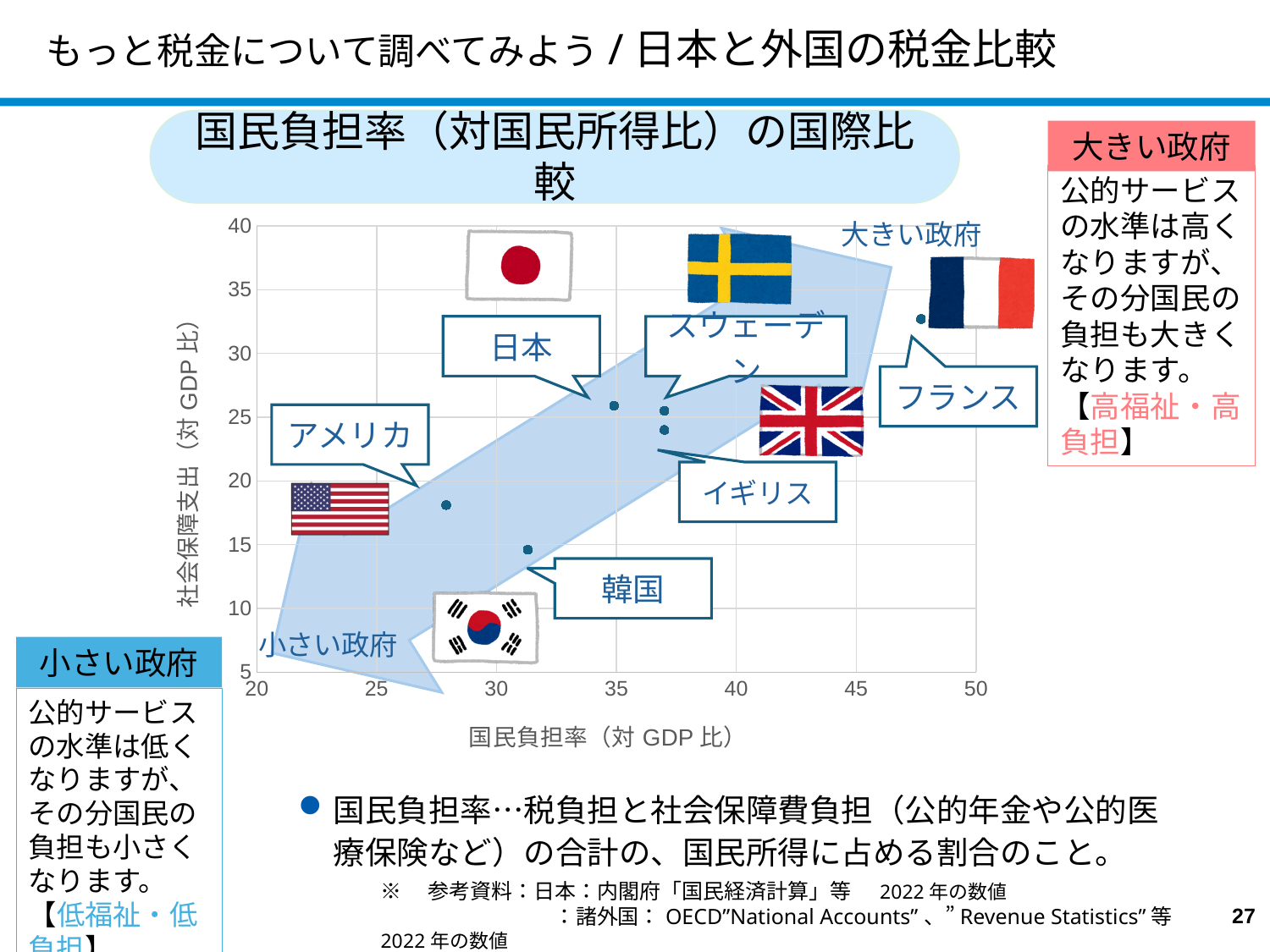
Which country has the highest 国民負担率 (x-axis value) in the chart? フランス Is the 国民負担率 (x-axis value) for フランス greater or less than 45? greater Which has the higher 社会保障支出 (y-axis value), 日本 or アメリカ? 日本 What is the label of the x axis of the chart? 国民負担率（対 GDP 比） How many countries are plotted in the chart? 6 Is the 社会保障支出 (y-axis value) for 韓国 greater or less than 20? less What kind of chart is shown on the slide? scatter chart Do the plotted points generally rise or fall as 国民負担率 increases along the x axis? rise Which country has the lowest 国民負担率 (x-axis value) in the chart? アメリカ Is the 社会保障支出 (y-axis value) for スウェーデン greater or less than 20? greater Which country has the lowest 社会保障支出 (y-axis value) in the chart? 韓国